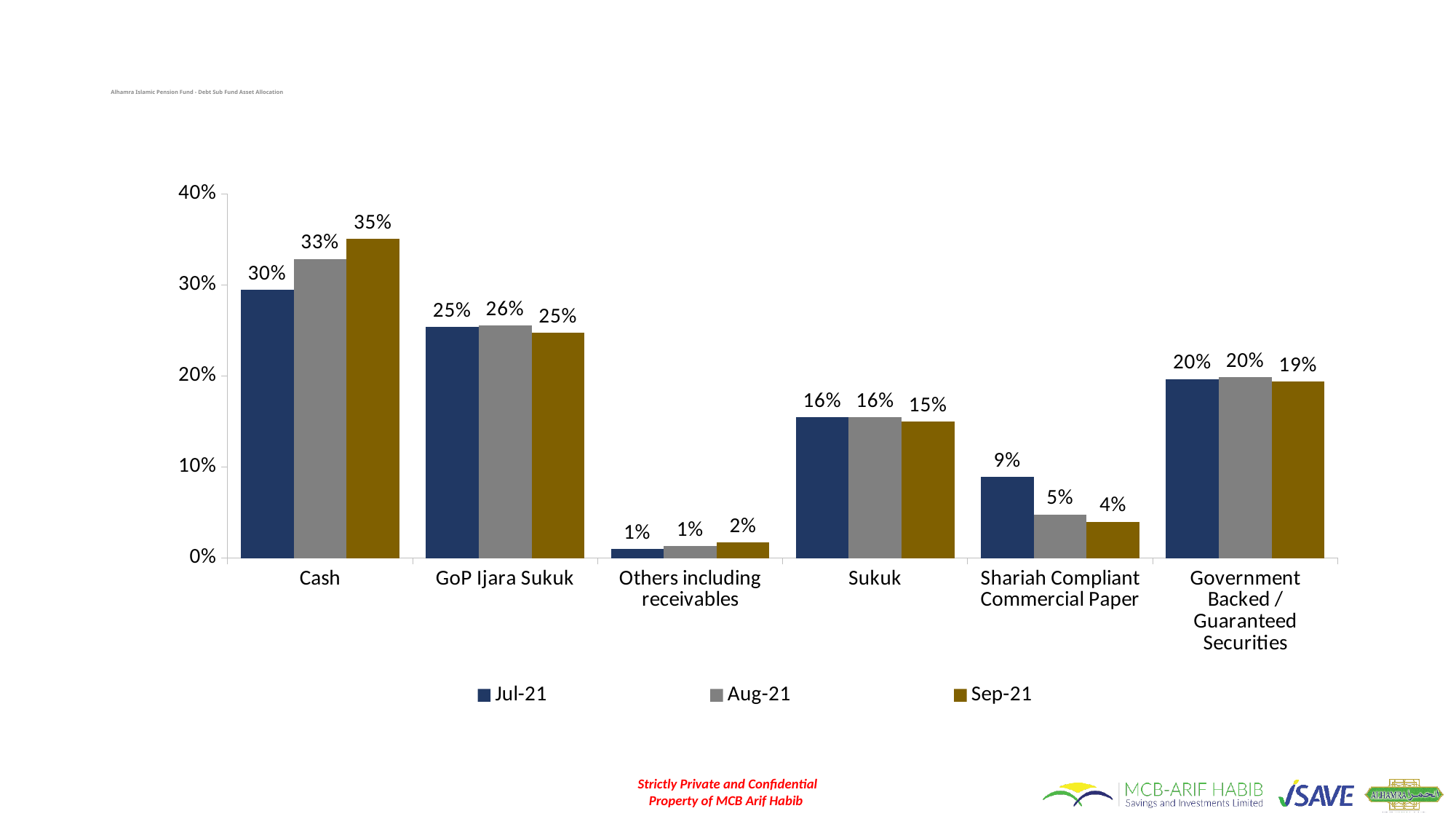
Is the Aug-21 value for GoP Ijara Sukuk greater or less than 20%? greater What is the value for Government Backed / Guaranteed Securities in Aug-21? 20% How many series does the legend list? 3 Which is larger for Shariah Compliant Commercial Paper: the Jul-21 value or the Sep-21 value? Jul-21 How many categories are shown on the x axis? 6 What is the difference between the Sep-21 and Jul-21 values for Cash? 5% Which category has the lowest value in Jul-21? Others including receivables Do the values for Cash rise or fall from Jul-21 to Sep-21? Rise What is the value for Shariah Compliant Commercial Paper in Jul-21? 9% What is the value for Cash in Sep-21? 35% Which category has the highest value in Sep-21? Cash What kind of chart is shown on the slide? Bar chart